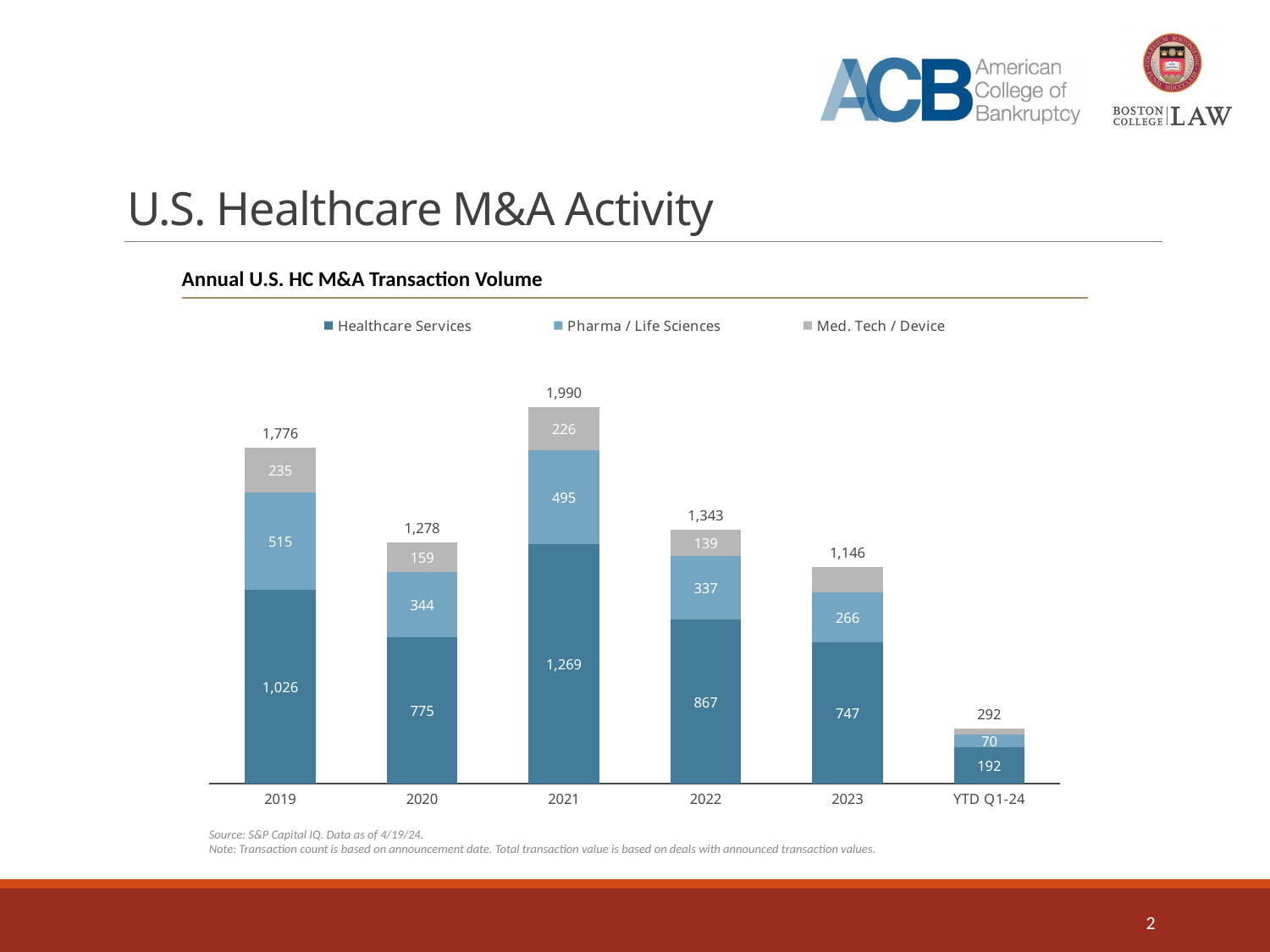
What is the Healthcare Services value for 2019? 1,026 What is the Pharma / Life Sciences value for 2022? 337 What is the total transaction volume shown for 2021? 1,990 How many series does the legend list? 3 What is the title of the chart? Annual U.S. HC M&A Transaction Volume What is the difference between the Healthcare Services values for 2021 and 2020? 494 What kind of chart is shown on the slide? Stacked bar chart How many categories are shown on the x axis? 6 Which is larger, the Pharma / Life Sciences value for 2019 or for 2021? 2019 Which year has the highest total transaction volume? 2021 Which category has the lowest total transaction volume? YTD Q1-24 What is the Med. Tech / Device value for 2020? 159